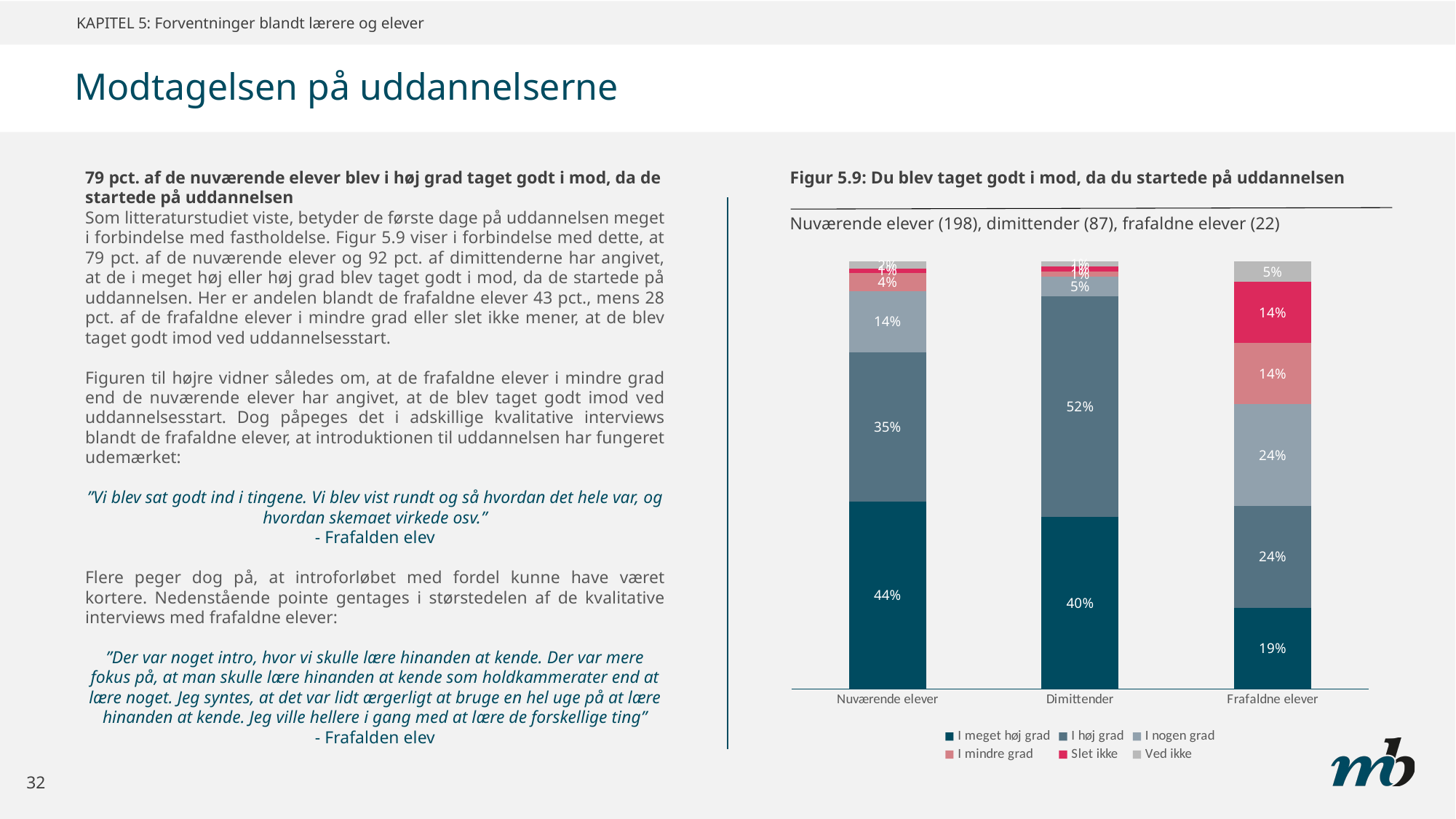
How many series does the legend of the chart list? 6 What is the value of 'I meget høj grad' for Frafaldne elever? 19% What is the value of 'I meget høj grad' for Nuværende elever? 44% Which is larger: 'I høj grad' for Dimittender or 'I høj grad' for Nuværende elever? Dimittender What is the difference between the 'I meget høj grad' values for Nuværende elever and Frafaldne elever? 25 percentage points What is the value of 'I høj grad' for Dimittender? 52% What is the value of 'I nogen grad' for Nuværende elever? 14% What is the value of 'Slet ikke' for Frafaldne elever? 14% What kind of chart is Figur 5.9? Stacked bar chart How many categories are shown on the x axis of the chart? 3 Which category has the highest value for 'I meget høj grad'? Nuværende elever Which category has the lowest value for 'I høj grad'? Frafaldne elever